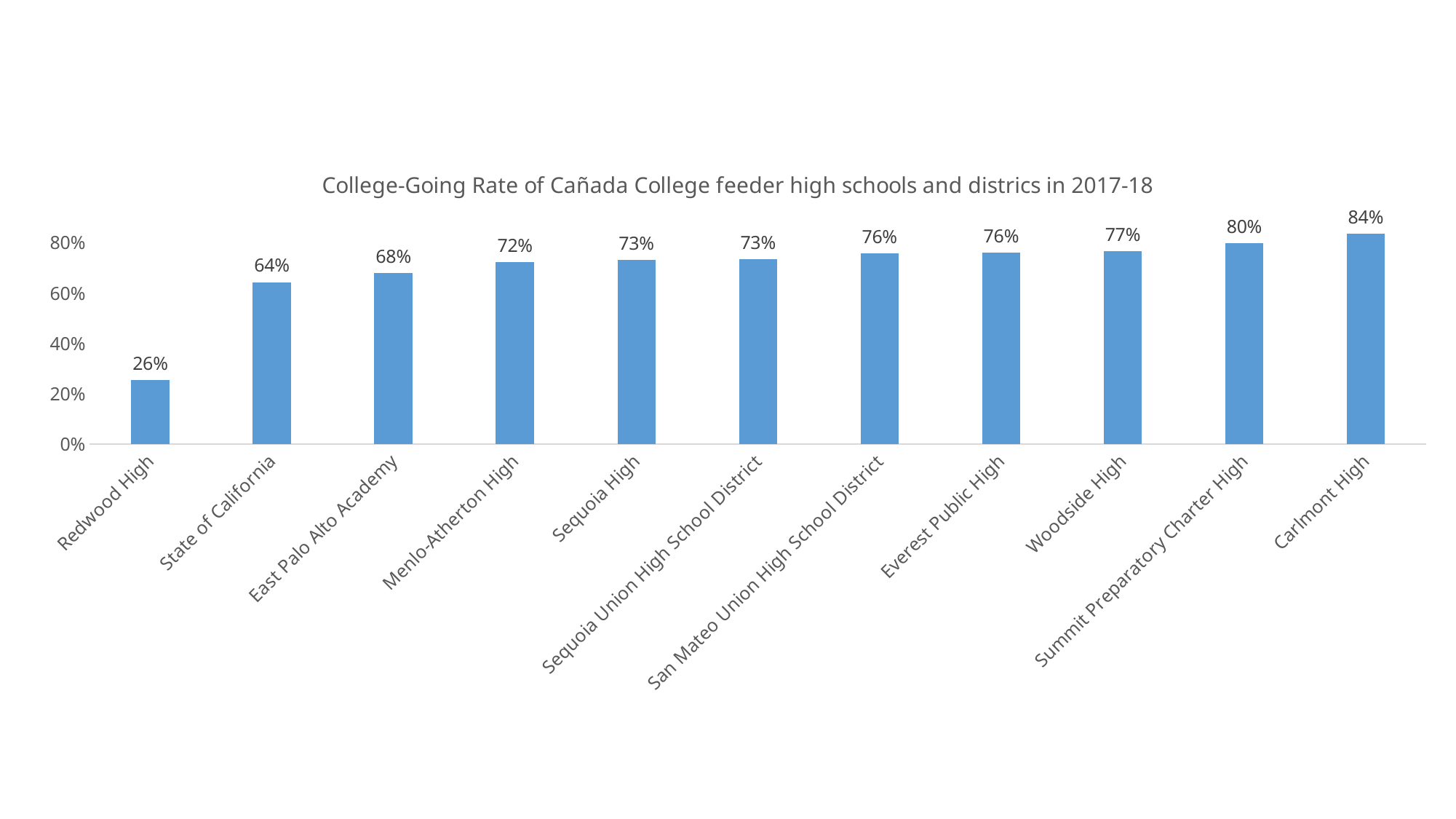
What is the title of the chart? College-Going Rate of Cañada College feeder high schools and districs in 2017-18 What type of chart is shown on the slide? Bar chart Which has a higher college-going rate, Everest Public High or State of California? Everest Public High What is the college-going rate for Summit Preparatory Charter High? 80% What is the college-going rate for Redwood High? 26% What is the difference between the college-going rates of Carlmont High and Redwood High? 58% Which school or district has the highest college-going rate? Carlmont High What is the college-going rate for the State of California? 64% How many schools and districts are shown in the chart? 11 What is the difference between the college-going rates of Menlo-Atherton High and East Palo Alto Academy? 4% What is the college-going rate for Woodside High? 77% Which school or district has the lowest college-going rate? Redwood High